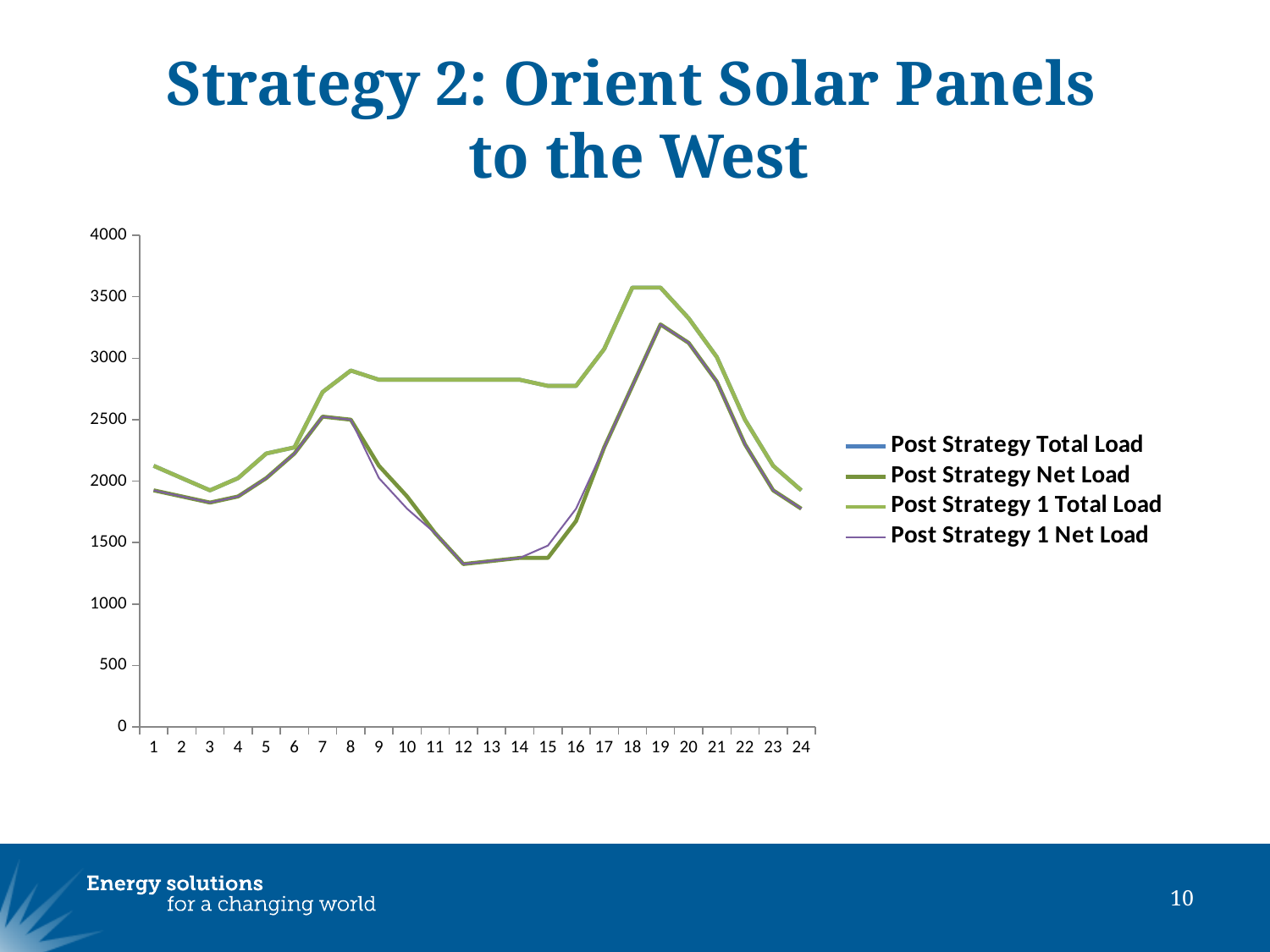
How many series does the legend list? 4 What kind of chart is shown on the slide? line chart How many points are labelled along the x axis? 24 Is the value of Post Strategy Net Load at hour 12 greater or less than 1500? less Is the value of Post Strategy 1 Total Load at hour 8 greater or less than 2500? greater Is the value of Post Strategy 1 Total Load at hour 18 greater or less than 3000? greater What is the title of the slide containing the chart? Strategy 2: Orient Solar Panels to the West Does Post Strategy Net Load rise or fall from hour 12 to hour 19? rise At which hour does Post Strategy Net Load reach its highest value? 19 Does Post Strategy 1 Total Load rise or fall from hour 19 to hour 24? fall At hour 12, which is larger: Post Strategy 1 Total Load or Post Strategy Net Load? Post Strategy 1 Total Load